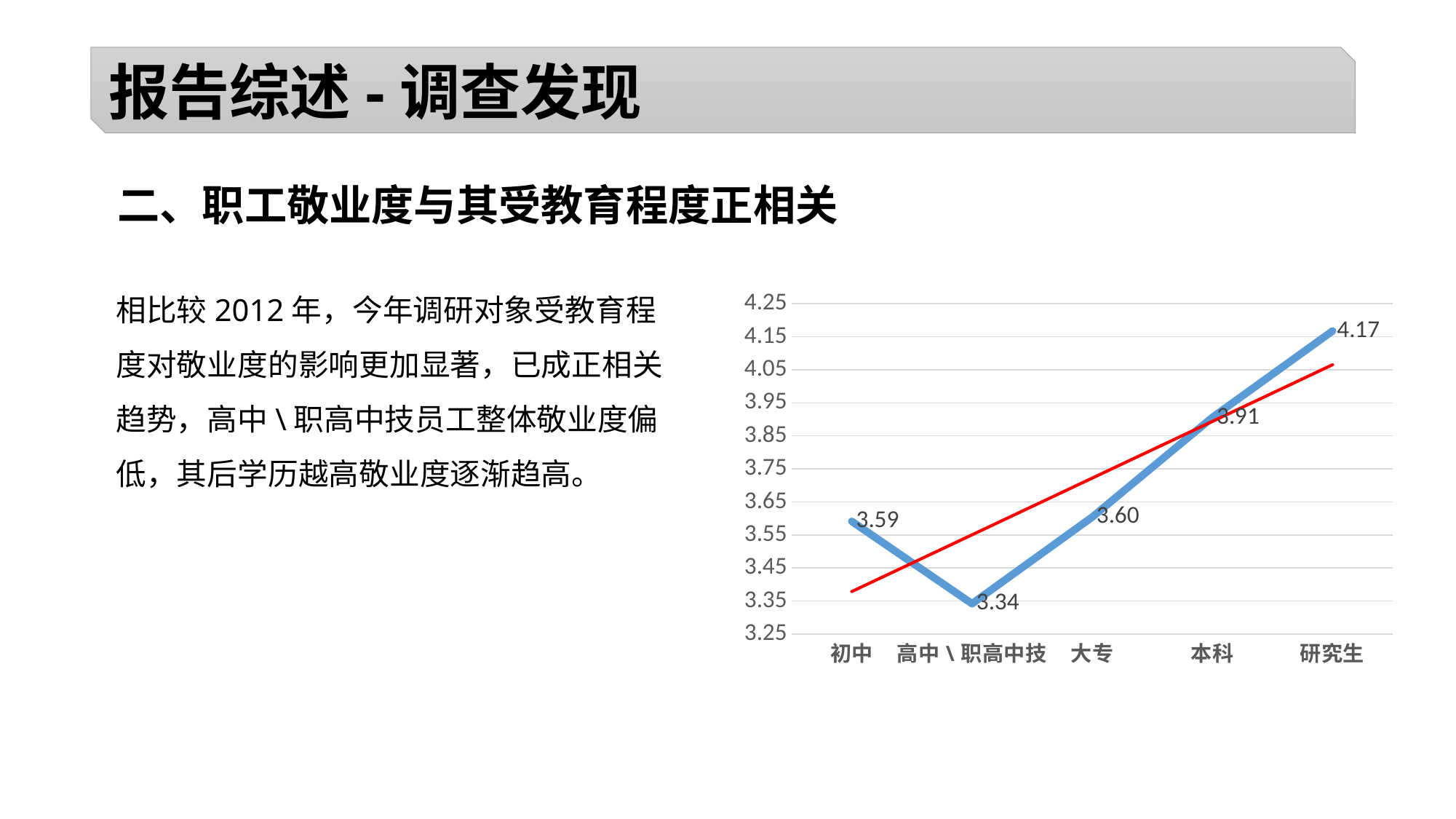
What is the value for 本科? 3.91 What is the difference between the values for 研究生 and 本科? 0.26 What is the value for 高中＼职高中技? 3.34 How many categories are shown on the x axis? 5 What is the value for 研究生? 4.17 What is the value for 初中? 3.59 What is the value for 大专? 3.60 Do the values rise or fall from 大专 to 研究生? rise Which category has the highest value? 研究生 Which category has the lowest value? 高中＼职高中技 What kind of chart is this? line chart Which is larger, the value for 初中 or the value for 高中＼职高中技? 初中